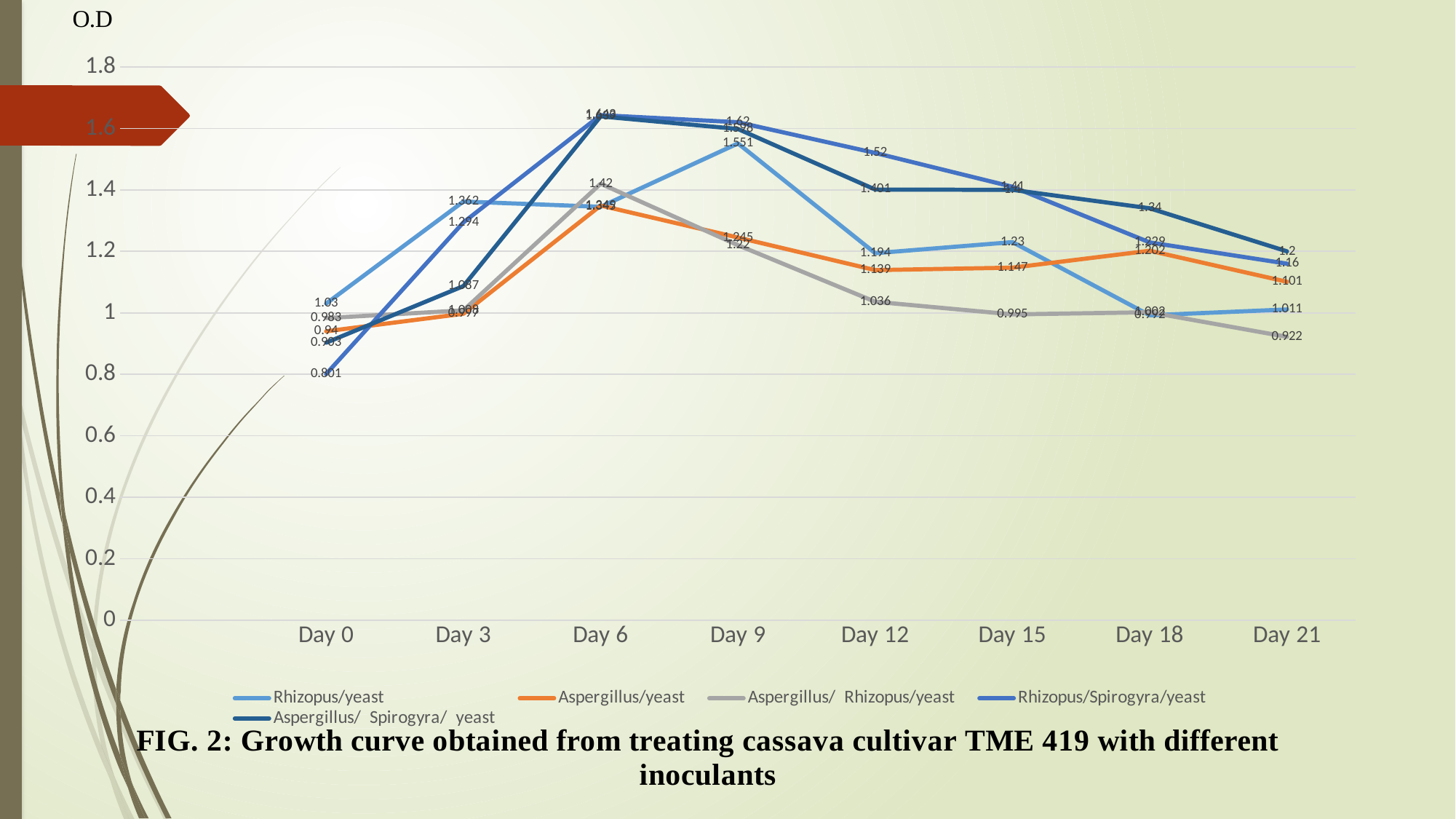
What is the difference between the Rhizopus/yeast values on Day 3 and Day 0? 0.332 What is the value for Rhizopus/Spirogyra/yeast on Day 0? 0.801 On Day 12, which is larger: Rhizopus/Spirogyra/yeast or Aspergillus/ Rhizopus/yeast? Rhizopus/Spirogyra/yeast Is the value for Rhizopus/Spirogyra/yeast on Day 9 greater or less than 1.4? greater What kind of chart is shown on the slide? line chart What is the value for Aspergillus/ Rhizopus/yeast on Day 21? 0.922 What is the value for Aspergillus/ Spirogyra/ yeast on Day 18? 1.34 What is the value for Rhizopus/yeast on Day 9? 1.551 How many series does the legend list? 5 Which series has the lowest value on Day 0? Rhizopus/Spirogyra/yeast Which series has the lowest value on Day 21? Aspergillus/ Rhizopus/yeast How many day points are shown on the x axis? 8